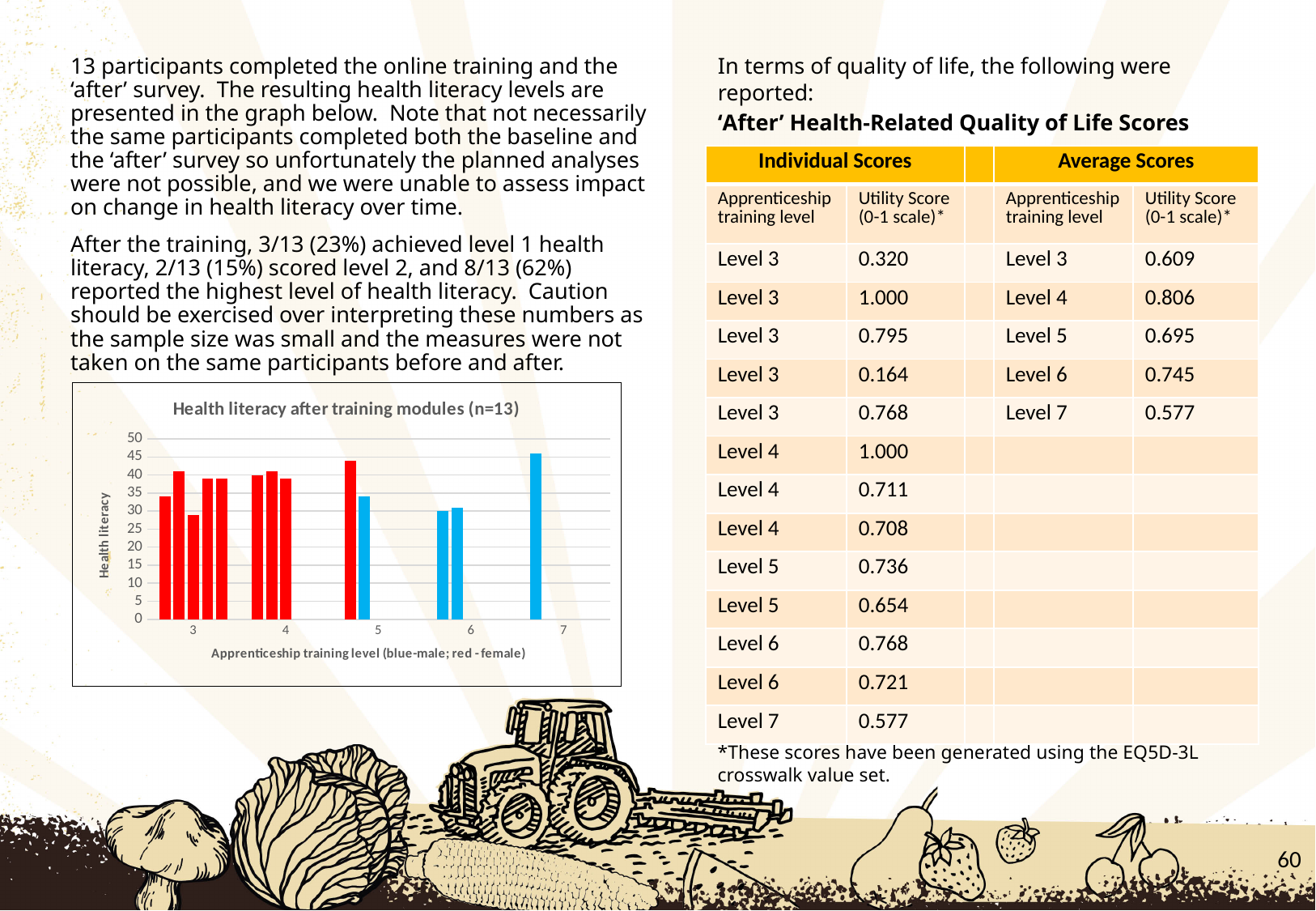
What is the title of the chart? Health literacy after training modules (n=13) Are the health literacy values for the two level 6 participants greater or less than 35? less How many bars are plotted for apprenticeship training level 3? 5 How many apprenticeship training levels are shown on the x-axis of the chart? 5 Is the health literacy value for the blue (male) bar at level 5 greater or less than 40? less What kind of chart is shown on the slide? bar chart At level 5, which bar is taller: the red (female) bar or the blue (male) bar? the red (female) bar How many blue (male) bars are plotted in the chart? 4 Is the health literacy value for the level 7 participant greater or less than 40? greater According to the x-axis label, which colour represents male participants in the chart? blue